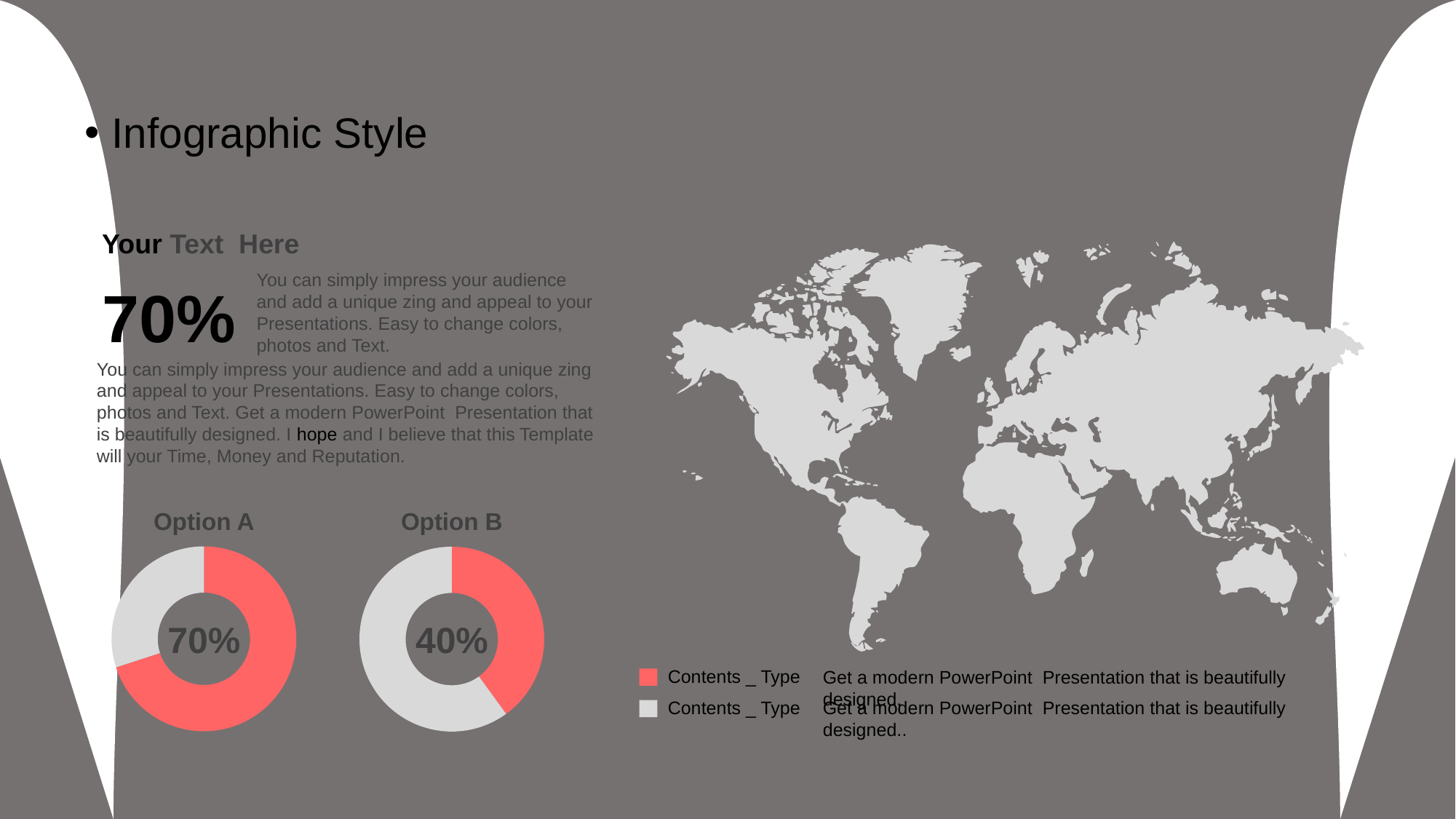
What is the difference between the percentage shown for Option A and the percentage shown for Option B? 30% In the Option A donut chart, what share of the ring is coloured red? 70% In the Option B donut chart, what share of the ring is coloured red? 40% What value is shown in the centre of the Option A donut chart? 70% What value is shown in the centre of the Option B donut chart? 40% Which of the two donut charts, Option A or Option B, shows the higher percentage? Option A Which of the two donut charts, Option A or Option B, shows the lower percentage? Option B How many entries does the legend below the world map list? 2 What kind of chart is used for Option A and Option B? Donut chart Is the percentage shown for Option B greater or less than 50%? less What colour is the larger slice in the Option A donut chart? Red How many donut charts are shown on the slide? 2